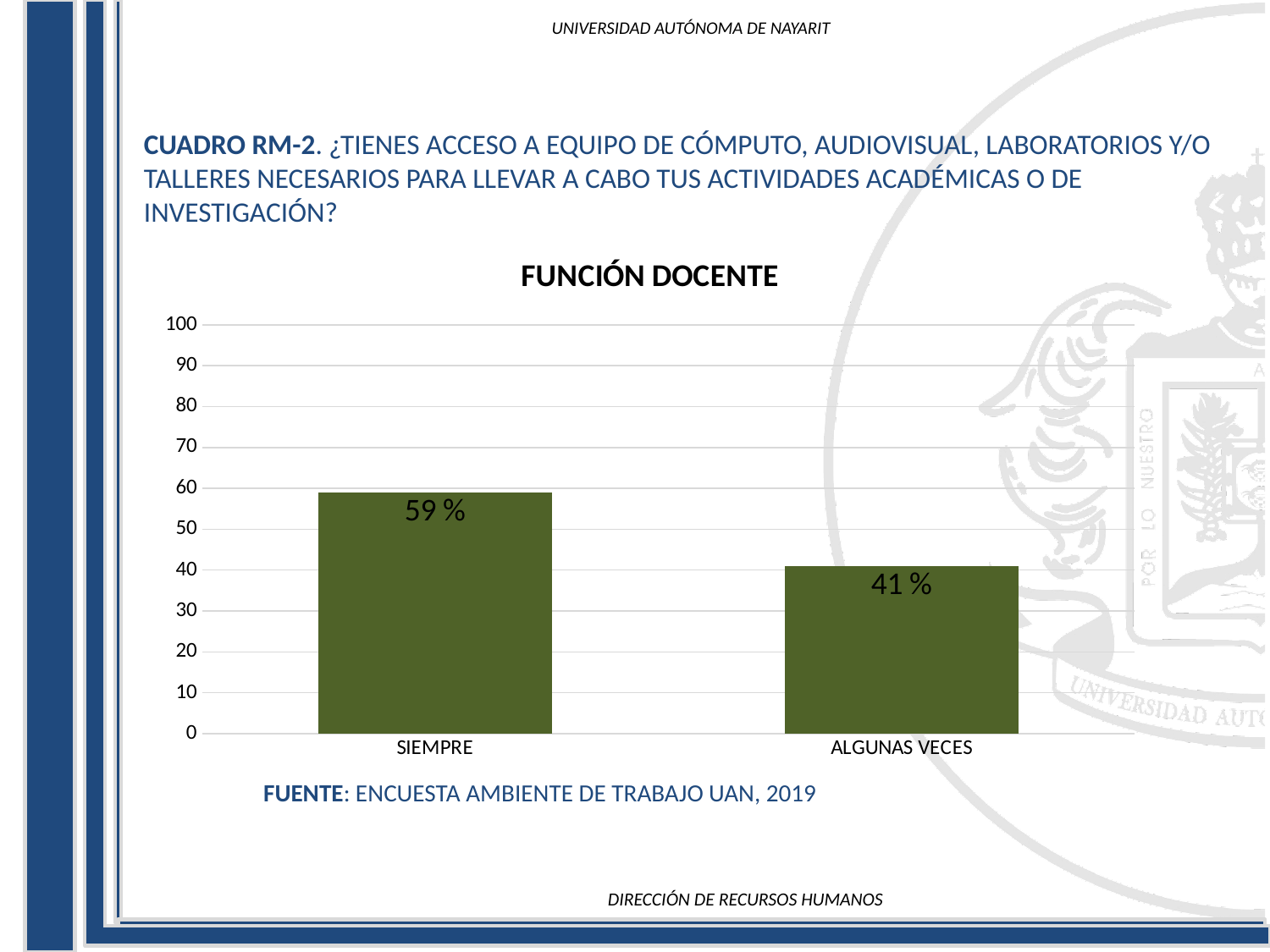
What is the value for ALGUNAS VECES? 41 % What is the maximum value shown on the vertical axis? 100 What is the difference between the values for SIEMPRE and ALGUNAS VECES? 18 % What is the title of the chart? FUNCIÓN DOCENTE Which category has the lowest value? ALGUNAS VECES How many categories are shown on the chart? 2 What kind of chart is shown on the slide? bar chart Is the value for SIEMPRE greater or less than 50? greater Which is larger, the value for SIEMPRE or the value for ALGUNAS VECES? SIEMPRE Which category has the highest value? SIEMPRE Is the value for ALGUNAS VECES greater or less than 50? less What is the value for SIEMPRE? 59 %